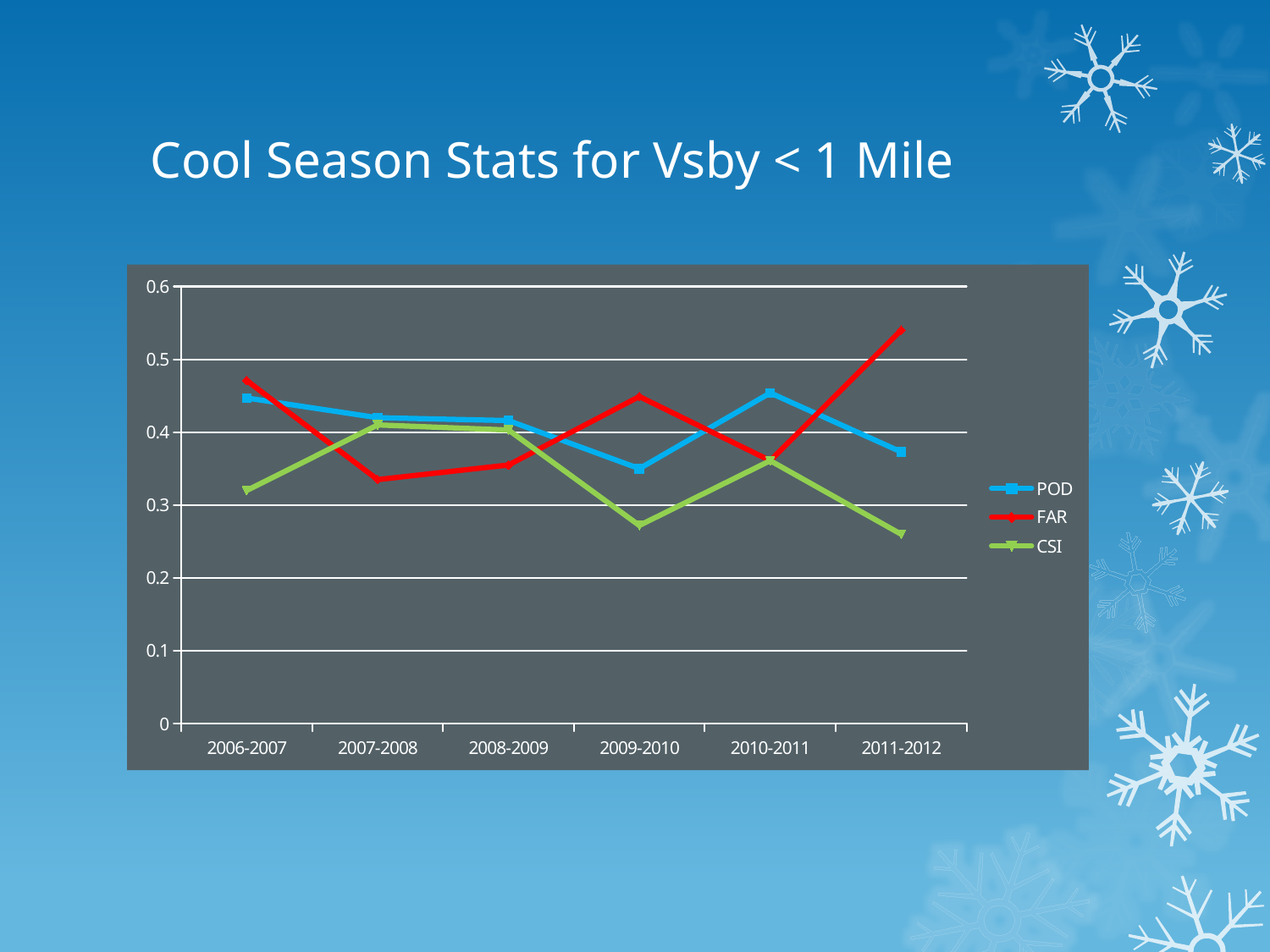
How many series does the legend list? 3 Which is larger in 2007-2008, POD or FAR? POD Is the POD value for 2006-2007 greater or less than 0.4? greater Is the CSI value for 2009-2010 greater or less than 0.3? less What kind of chart is shown on the slide? line chart Is the FAR value for 2007-2008 greater or less than 0.4? less Does the FAR line rise or fall from 2010-2011 to 2011-2012? rise What is the title of the slide containing the chart? Cool Season Stats for Vsby < 1 Mile In which season is the FAR value highest? 2011-2012 Which is larger in 2011-2012, FAR or CSI? FAR How many seasons are shown on the x axis? 6